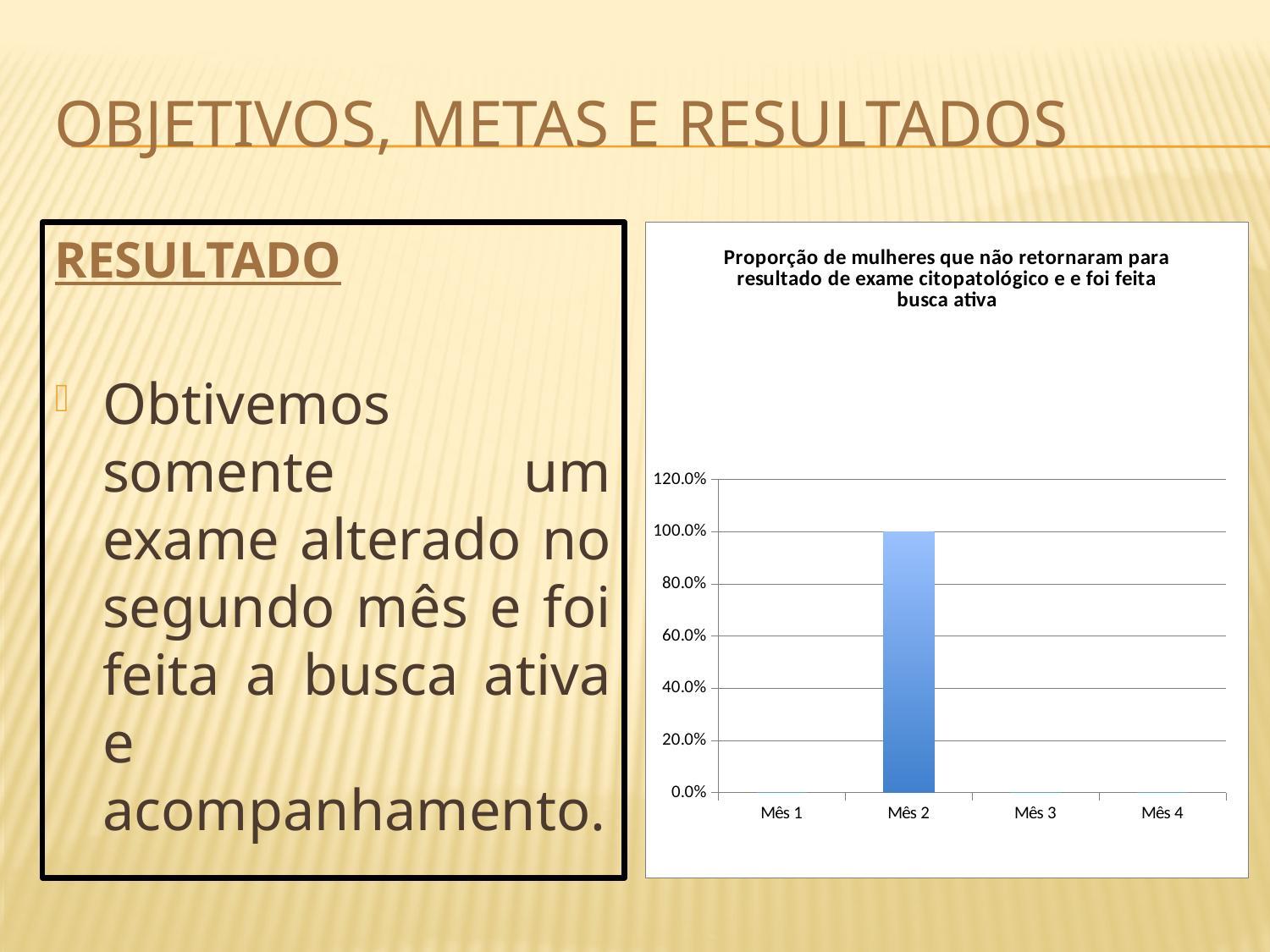
What is the highest tick value shown on the y axis of the chart? 120.0% Is the value for Mês 1 greater or less than 20.0%? less Which month has the highest value in the chart? Mês 2 Which is larger, the value for Mês 2 or the value for Mês 4? Mês 2 What is the value for Mês 4 in the chart? 0.0% What kind of chart is shown on the slide? bar chart Is the value for Mês 2 greater or less than 80.0%? greater How many categories are shown on the x axis of the chart? 4 Is the value for Mês 3 greater or less than 20.0%? less What is the title of the chart? Proporção de mulheres que não retornaram para resultado de exame citopatológico e e foi feita busca ativa What is the value for Mês 2 in the chart? 100.0%